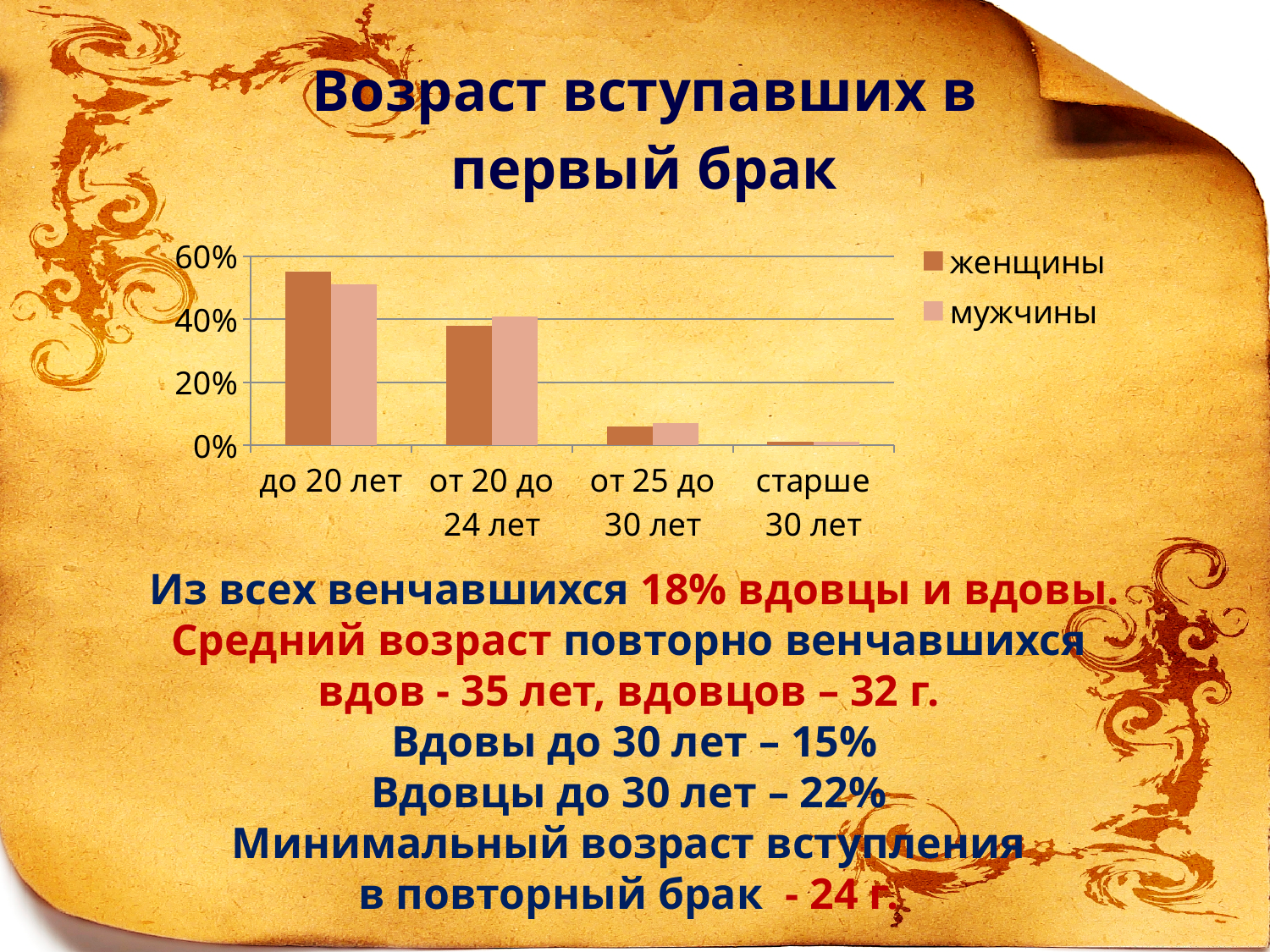
What is the title of the chart? Возраст вступавших в первый брак What kind of chart is shown on the slide? bar chart Is the value for мужчины in the category от 20 до 24 лет greater or less than 20%? greater How many series does the chart legend list? 2 Which age category has the lowest value for мужчины? старше 30 лет In the category до 20 лет, which series has the larger value, женщины or мужчины? женщины Is the value for женщины in the category от 25 до 30 лет greater or less than 20%? less Which age category has the highest value for женщины? до 20 лет How many age categories are shown on the x axis of the chart? 4 Do the values for женщины rise or fall as you move from до 20 лет to старше 30 лет along the x axis? fall Is the value for женщины in the category до 20 лет greater or less than 40%? greater What are the two series named in the chart legend? женщины and мужчины